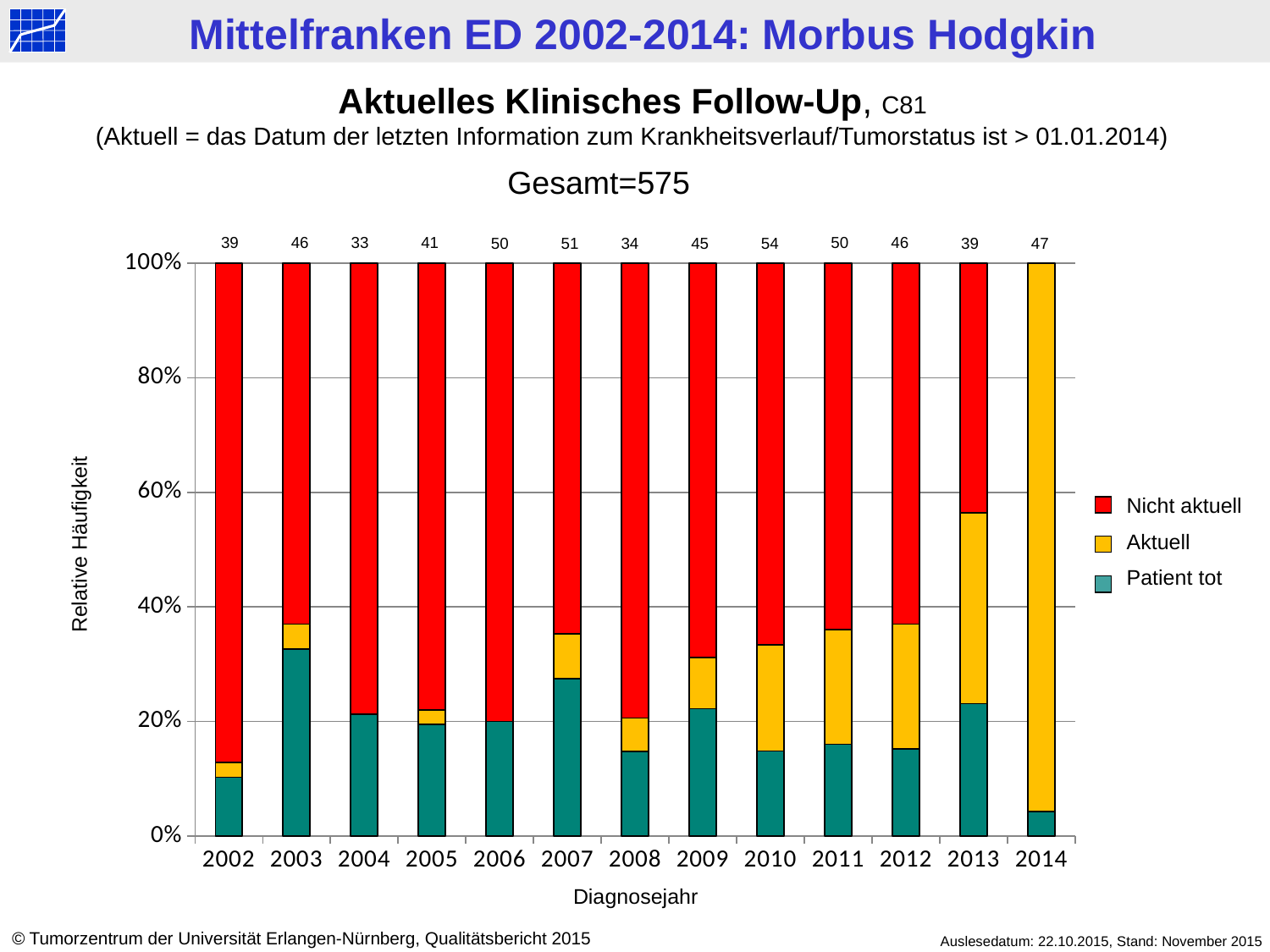
What is the difference between the numbers printed above the bars for 2010 and 2004? 21 What kind of chart is shown on the slide? bar chart What number is printed above the bar for 2004? 33 Which diagnosis year has the highest number printed above its bar? 2010 Which year has the larger 'Patient tot' share, 2002 or 2003? 2003 What number is printed above the bar for 2010? 54 How many series does the legend list? 3 Which diagnosis year has the lowest number printed above its bar? 2004 What is the label of the x axis? Diagnosejahr How many diagnosis years (categories) are shown on the x axis? 13 Is the 'Patient tot' share for 2003 greater or less than 20%? greater Is the 'Aktuell' share for 2014 greater or less than 80%? greater